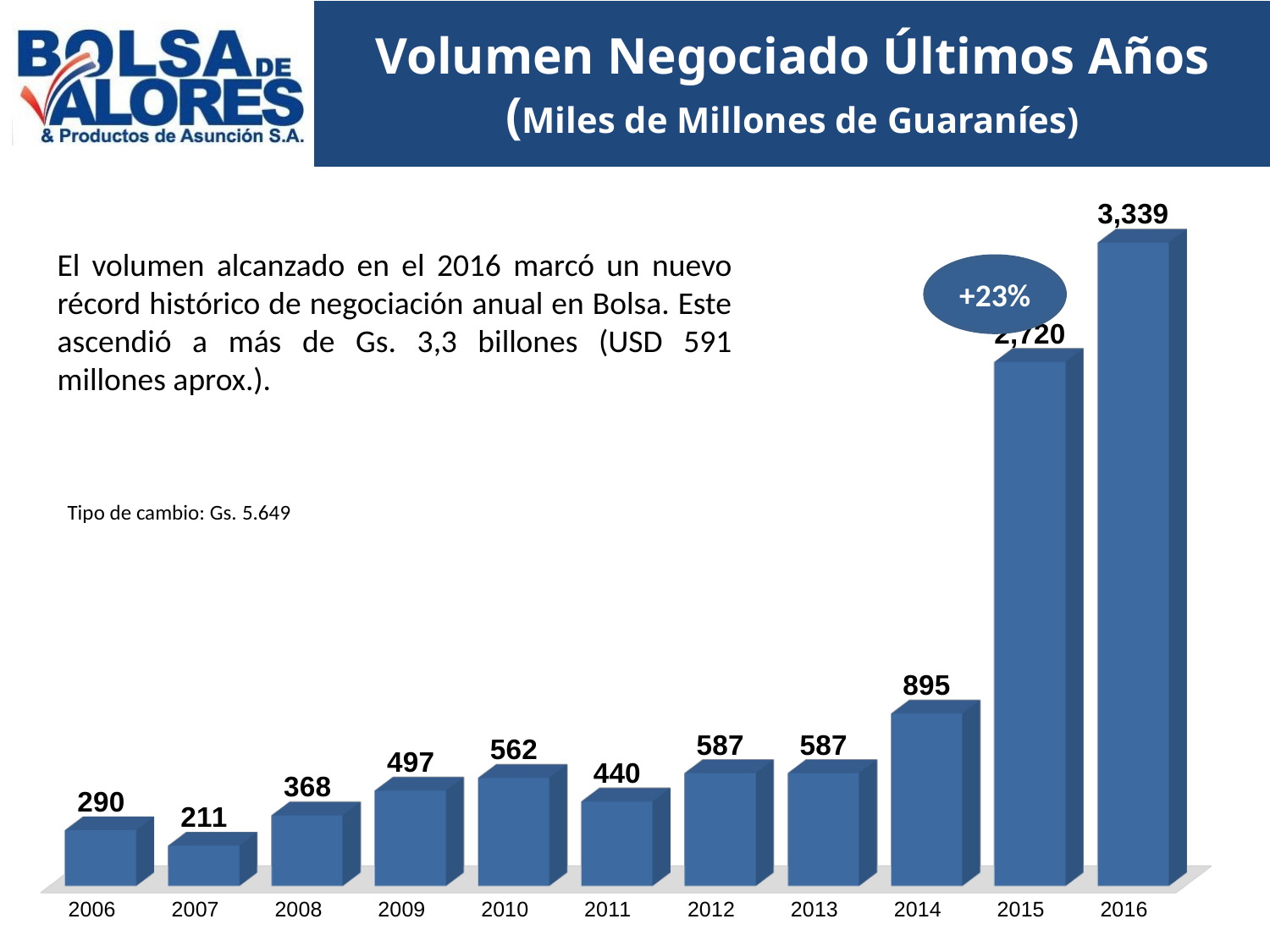
Which year has the larger value, 2010 or 2011? 2010 What is the difference between the values for 2009 and 2008? 129 What is the value for 2006? 290 How many years are shown on the x axis? 11 Which year has the highest value? 2016 What is the value for 2012? 587 What kind of chart is shown on the slide? Bar chart What is the value for 2014? 895 What percentage change is shown in the oval annotation above the 2015 bar? +23% What is the value for 2016? 3,339 What is the difference between the values for 2014 and 2013? 308 Which year has the lowest value? 2007